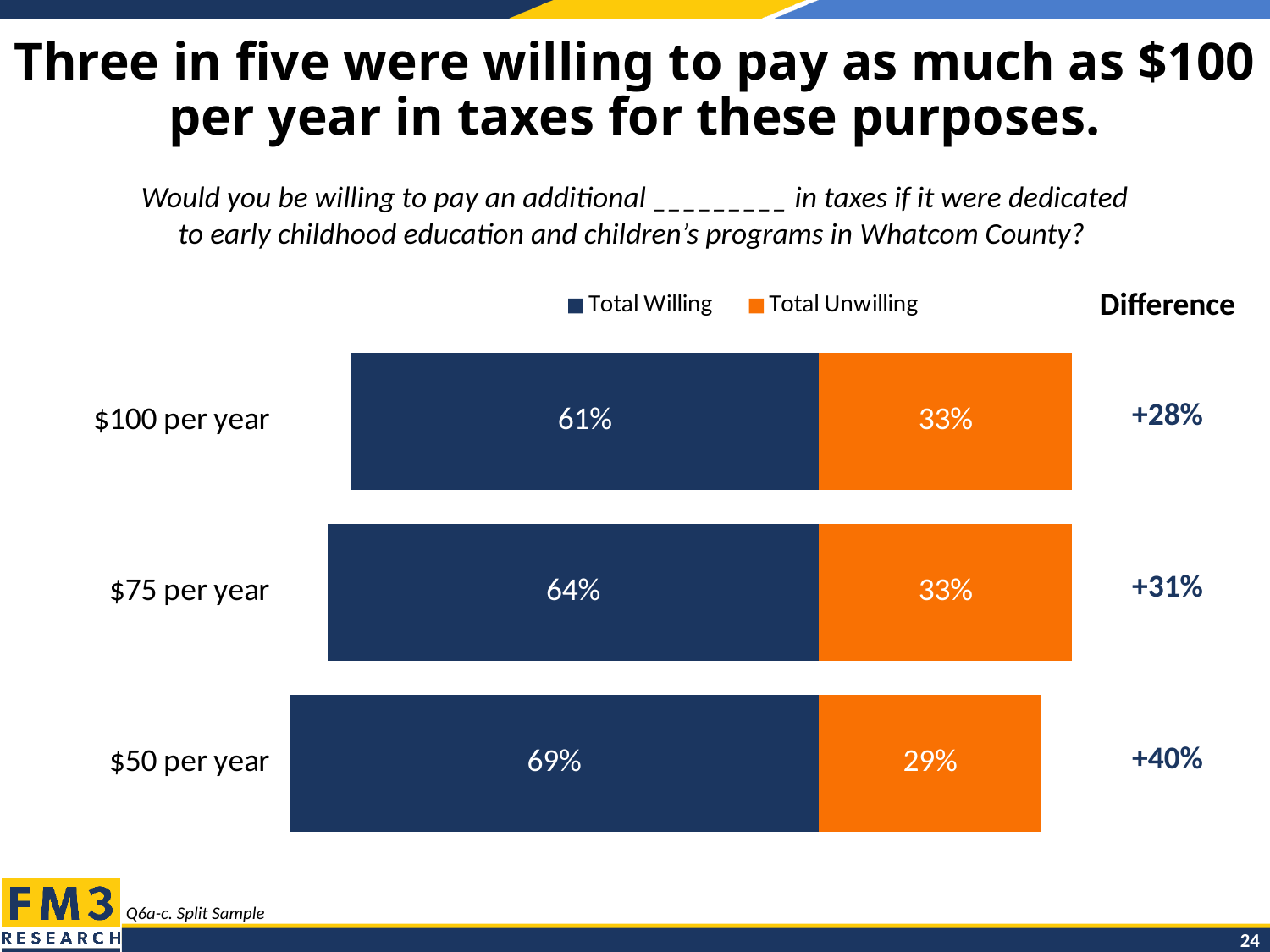
What percentage were Total Willing to pay $100 per year? 61% What is the difference between the Total Willing values for $50 per year and $100 per year? 8% How many series does the legend list? 2 Which colour represents Total Unwilling in the chart? Orange Is the Total Willing value larger for $75 per year or $100 per year? $75 per year What percentage were Total Unwilling to pay $50 per year? 29% Which amount has the highest Total Willing percentage? $50 per year What kind of chart is shown on the slide? Stacked bar chart How many tax amounts are shown in the chart? 3 Which amount has the lowest Total Willing percentage? $100 per year What is the Difference value shown for $50 per year? +40% What is the Total Willing value for $75 per year? 64%